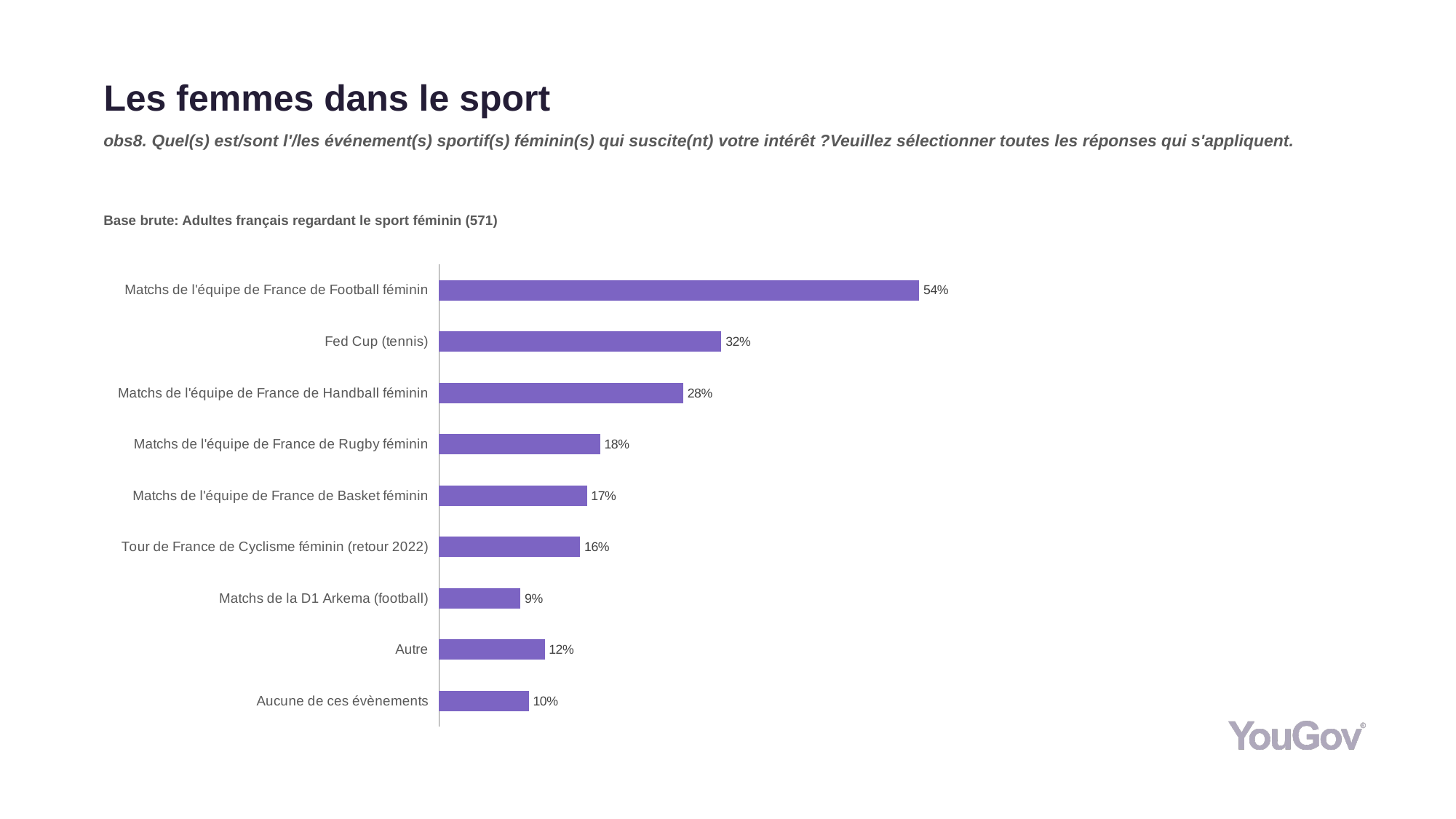
What is the value for Matchs de l'équipe de France de Football féminin? 54% What is the difference between the values for Matchs de l'équipe de France de Football féminin and Matchs de l'équipe de France de Rugby féminin? 36% What is the value for Aucune de ces évènements? 10% Which category has the highest value? Matchs de l'équipe de France de Football féminin What is the difference between the values for Fed Cup (tennis) and Matchs de l'équipe de France de Handball féminin? 4% What is the value for Tour de France de Cyclisme féminin (retour 2022)? 16% How many categories are shown in the chart? 9 Which is larger: the value for Autre or the value for Matchs de la D1 Arkema (football)? Autre What is the value for Fed Cup (tennis)? 32% Which category has the lowest value? Matchs de la D1 Arkema (football) What kind of chart is shown on the slide? Bar chart What is the base size stated on the slide? 571